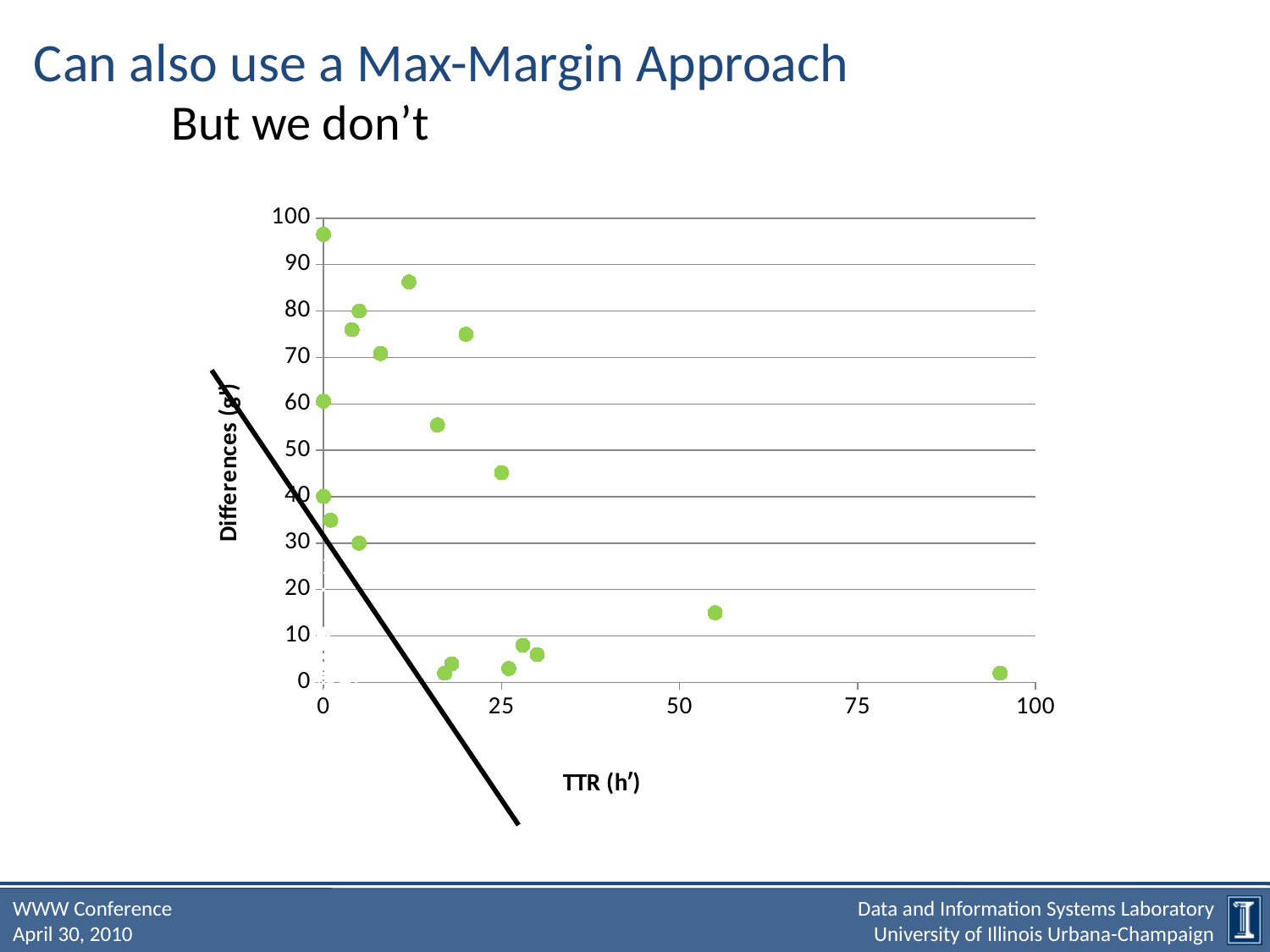
Is the Differences value of the point at TTR of about 12 greater or less than 80? greater As TTR increases along the x axis, do the Differences values generally rise or fall? fall What is the label of the y axis of the chart? Differences (g') What is the highest value shown on the y axis of the chart? 100 Is the Differences value of the point with the largest TTR (near 100) greater or less than 10? less What is the label of the x axis of the chart? TTR (h') Is the Differences value of the point at TTR of about 25 greater or less than 50? less Which has the larger Differences value: the point at TTR of about 55 or the point at TTR of about 95? the point at TTR of about 55 What kind of chart is shown on the slide? scatter plot